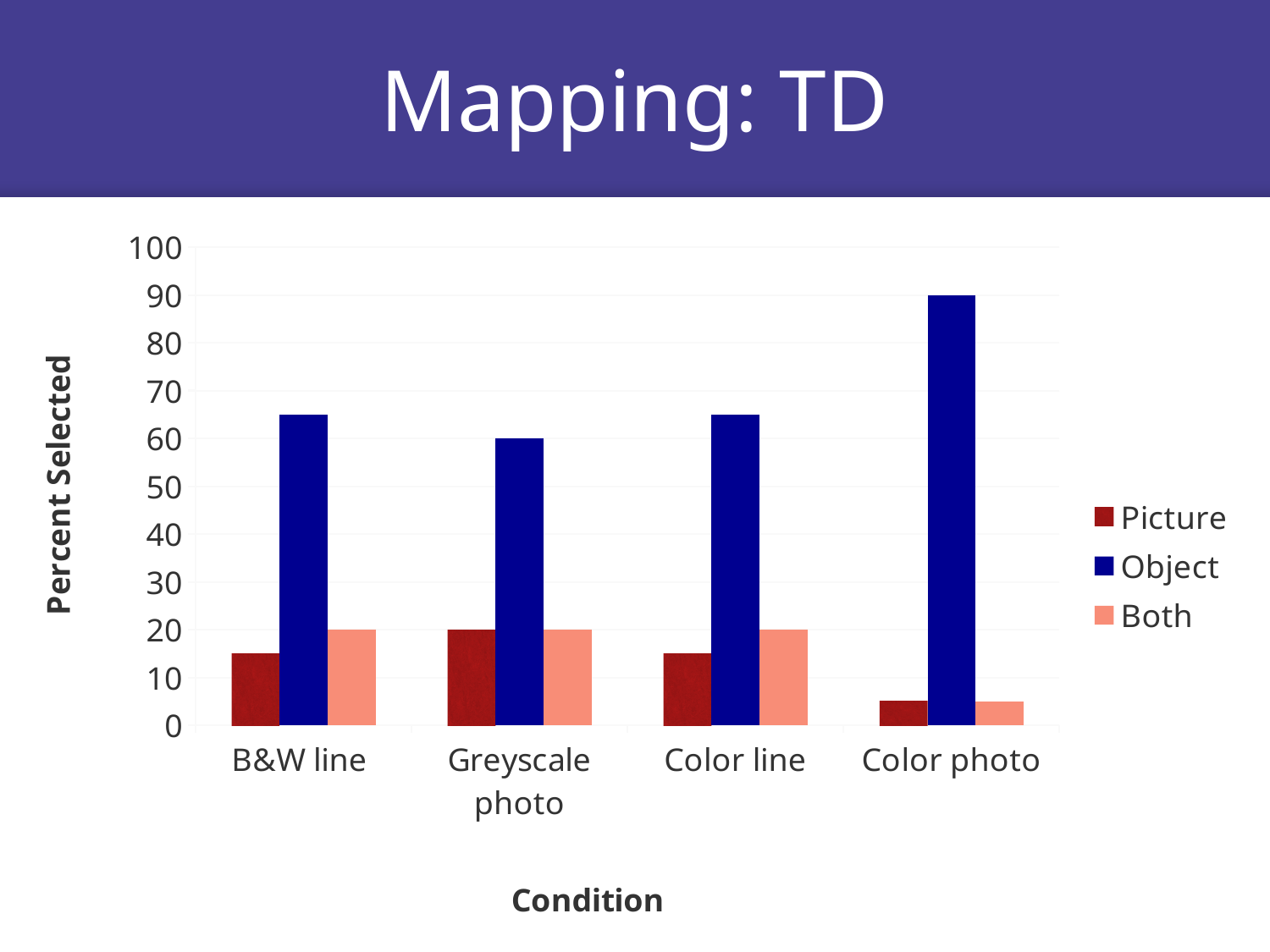
What is the Picture value for the Greyscale photo condition? 20 What is the Object value for the Greyscale photo condition? 60 How many series does the legend list? 3 Is the Object value for B&W line greater or less than 60? greater Which condition has the lowest Both value? Color photo What type of chart is shown on the slide? bar chart What is the label on the y axis? Percent Selected Which is larger for the Color line condition, Picture or Both? Both What is the Object value for the Color photo condition? 90 How many conditions are shown on the x axis? 4 What is the Both value for the B&W line condition? 20 Which condition has the highest Object value? Color photo